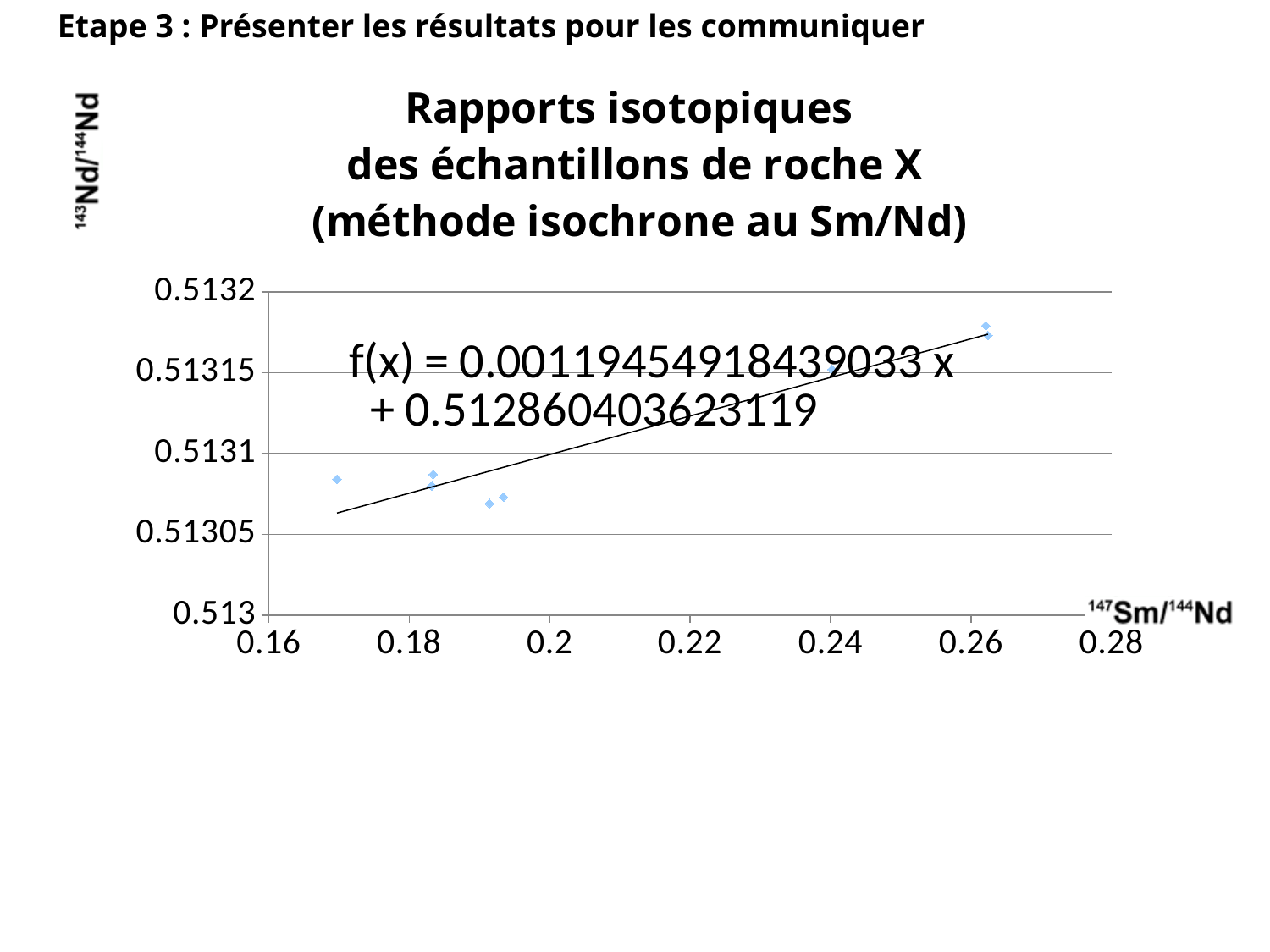
What is the label of the x axis? 147Sm/144Nd What kind of chart is shown on the slide? scatter chart Is the y value of the highest point (near x ≈ 0.26) greater or less than 0.51315? greater What is the slope of the trendline equation shown on the chart? 0.00119454918439033 What is the maximum value shown on the y axis? 0.5132 Is the y value of the point at x ≈ 0.17 greater or less than 0.5131? less What is the minimum value shown on the x axis? 0.16 Which has the larger y value: the point near x ≈ 0.26 or the point near x ≈ 0.17? the point near x ≈ 0.26 Do the plotted values generally rise or fall as the x-axis value increases? rise What is the title of the chart? Rapports isotopiques des échantillons de roche X (méthode isochrone au Sm/Nd) Are the y values of the points near x ≈ 0.19 greater or less than 0.51305? greater What is the intercept of the trendline equation shown on the chart? 0.512860403623119